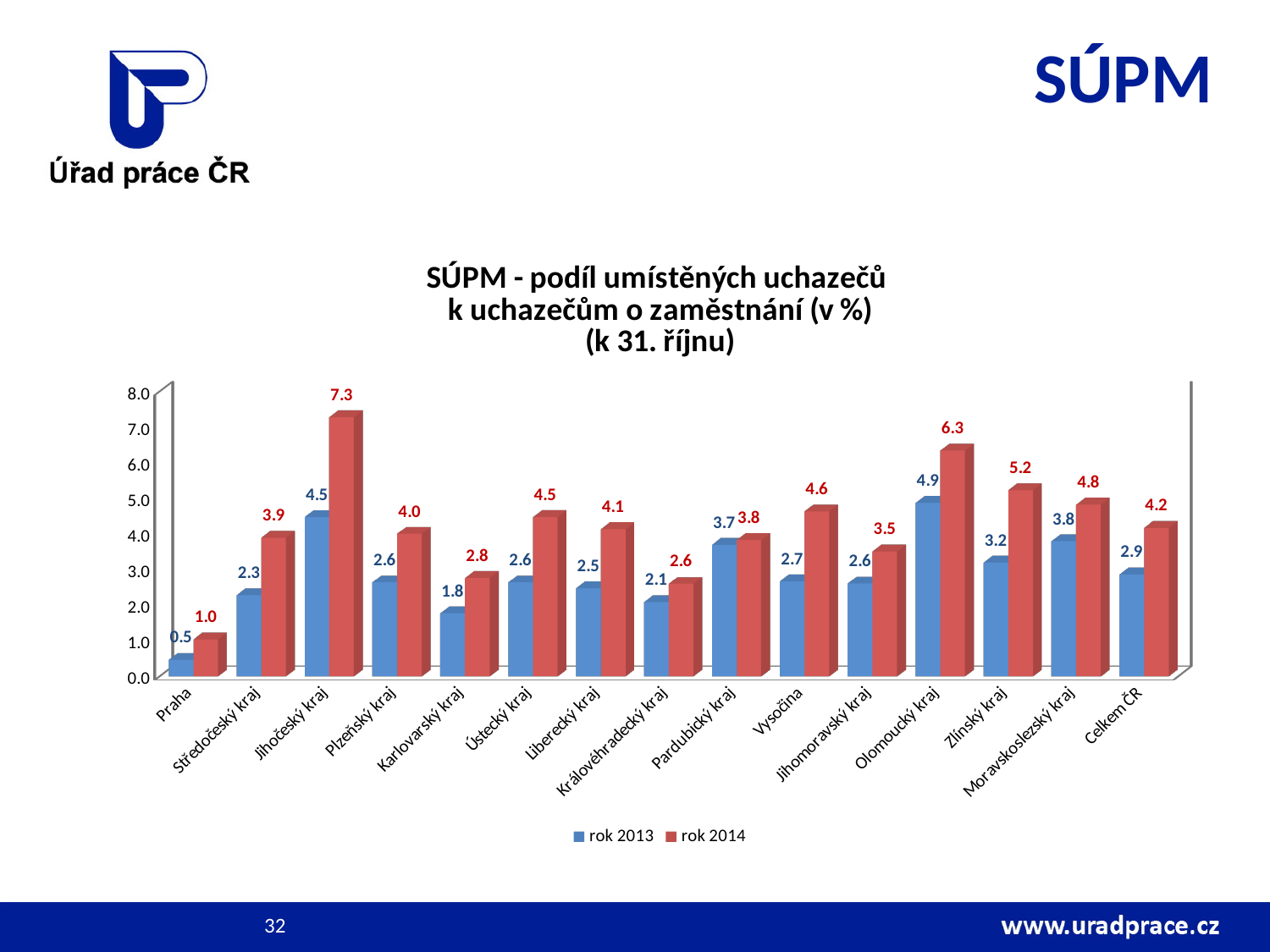
What are the two series listed in the legend? rok 2013 and rok 2014 Which is larger: the rok 2013 value for Moravskoslezský kraj or the rok 2013 value for Pardubický kraj? Moravskoslezský kraj Which category has the lowest rok 2013 value? Praha What is the rok 2014 value for Jihočeský kraj? 7.3 What is the difference between the rok 2014 and rok 2013 values for Zlínský kraj? 2.0 How many categories are shown on the x axis? 15 What is the rok 2013 value for Karlovarský kraj? 1.8 What kind of chart is shown on the slide? bar chart How many series does the legend list? 2 What is the rok 2013 value for Olomoucký kraj? 4.9 What is the rok 2014 value for Celkem ČR? 4.2 Which category has the highest rok 2014 value? Jihočeský kraj